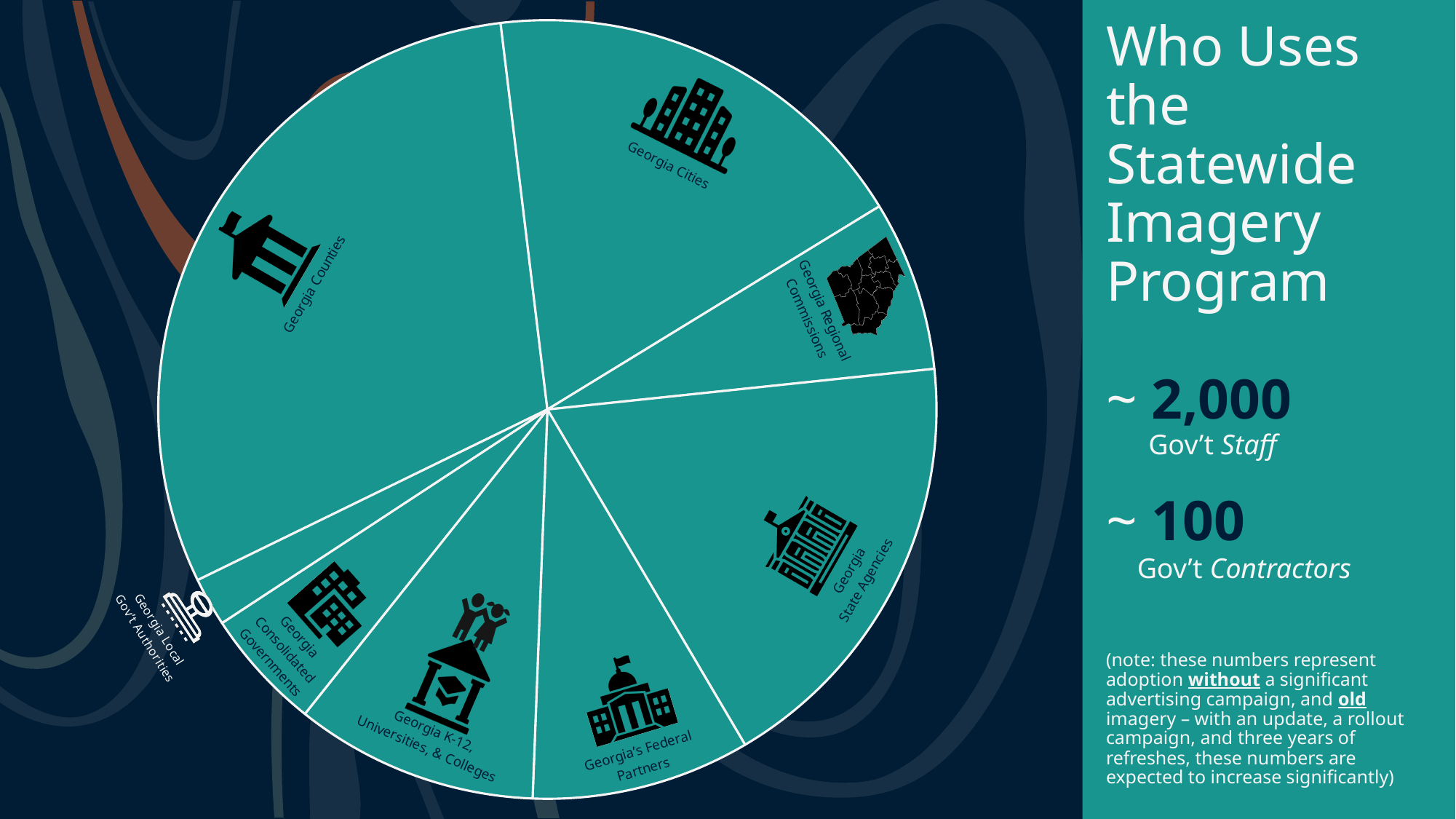
Which category has the largest slice of the pie chart? Georgia Counties Which slice is larger, Georgia Counties or Georgia State Agencies? Georgia Counties Which category has the smallest slice of the pie chart? Georgia Local Gov't Authorities Which slice is larger, Georgia State Agencies or Georgia's Federal Partners? Georgia State Agencies Which slice is larger, Georgia K-12, Universities, & Colleges or Georgia Consolidated Governments? Georgia K-12, Universities, & Colleges What kind of chart is shown on the slide? Pie chart What colour are the slices of the pie chart? Teal How many slices does the pie chart have? 8 What is the title shown next to the pie chart? Who Uses the Statewide Imagery Program